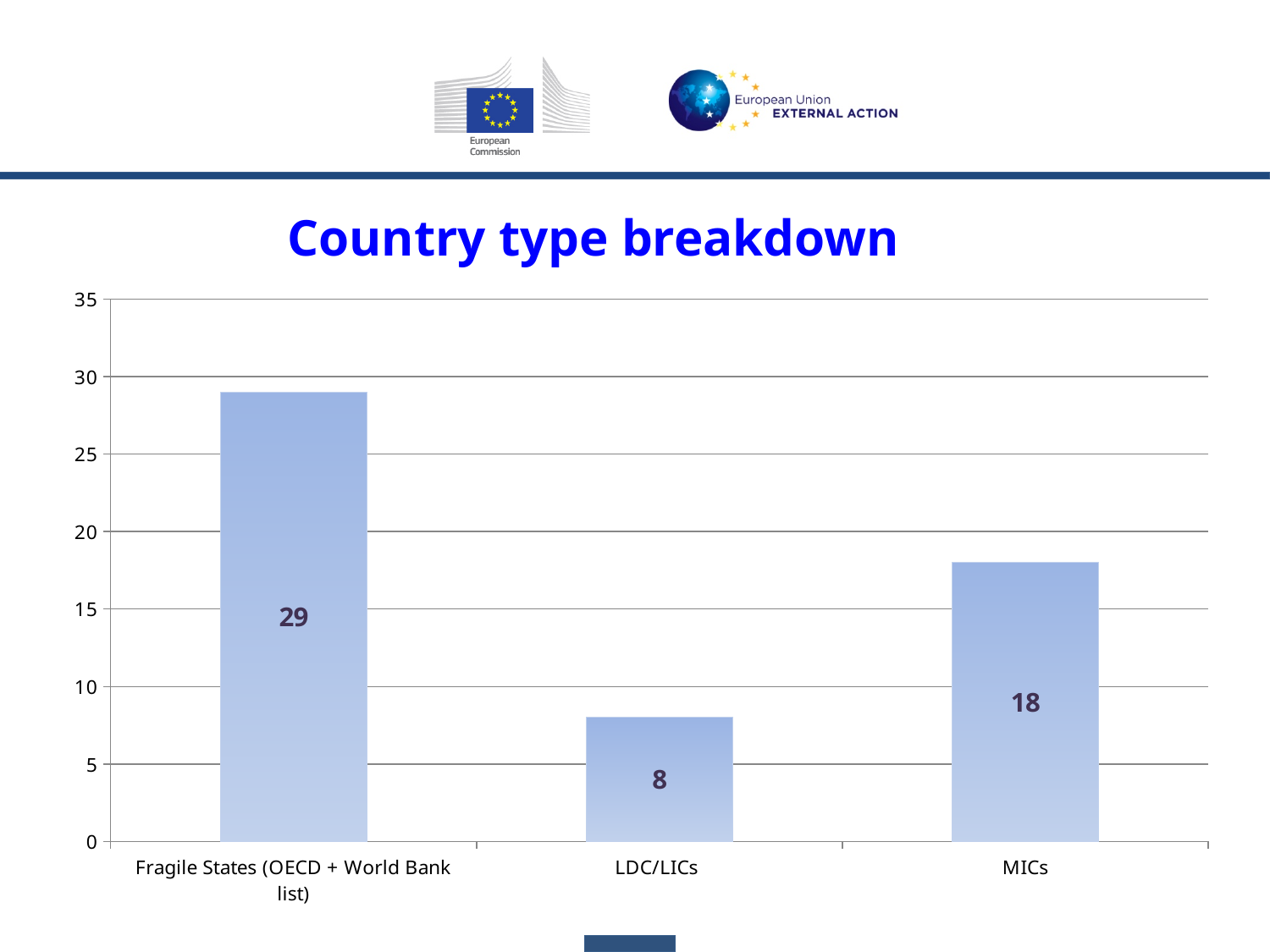
What is the value for LDC/LICs? 8 Which category has the highest value? Fragile States (OECD + World Bank list) Which is larger, the value for MICs or the value for LDC/LICs? MICs What is the title of the chart? Country type breakdown What is the value for MICs? 18 What is the value for Fragile States (OECD + World Bank list)? 29 Is the value for MICs greater or less than 20? less What is the difference between the values for MICs and LDC/LICs? 10 What kind of chart is shown on the slide? bar chart What is the difference between the values for Fragile States (OECD + World Bank list) and MICs? 11 How many categories are shown on the chart? 3 Which category has the lowest value? LDC/LICs